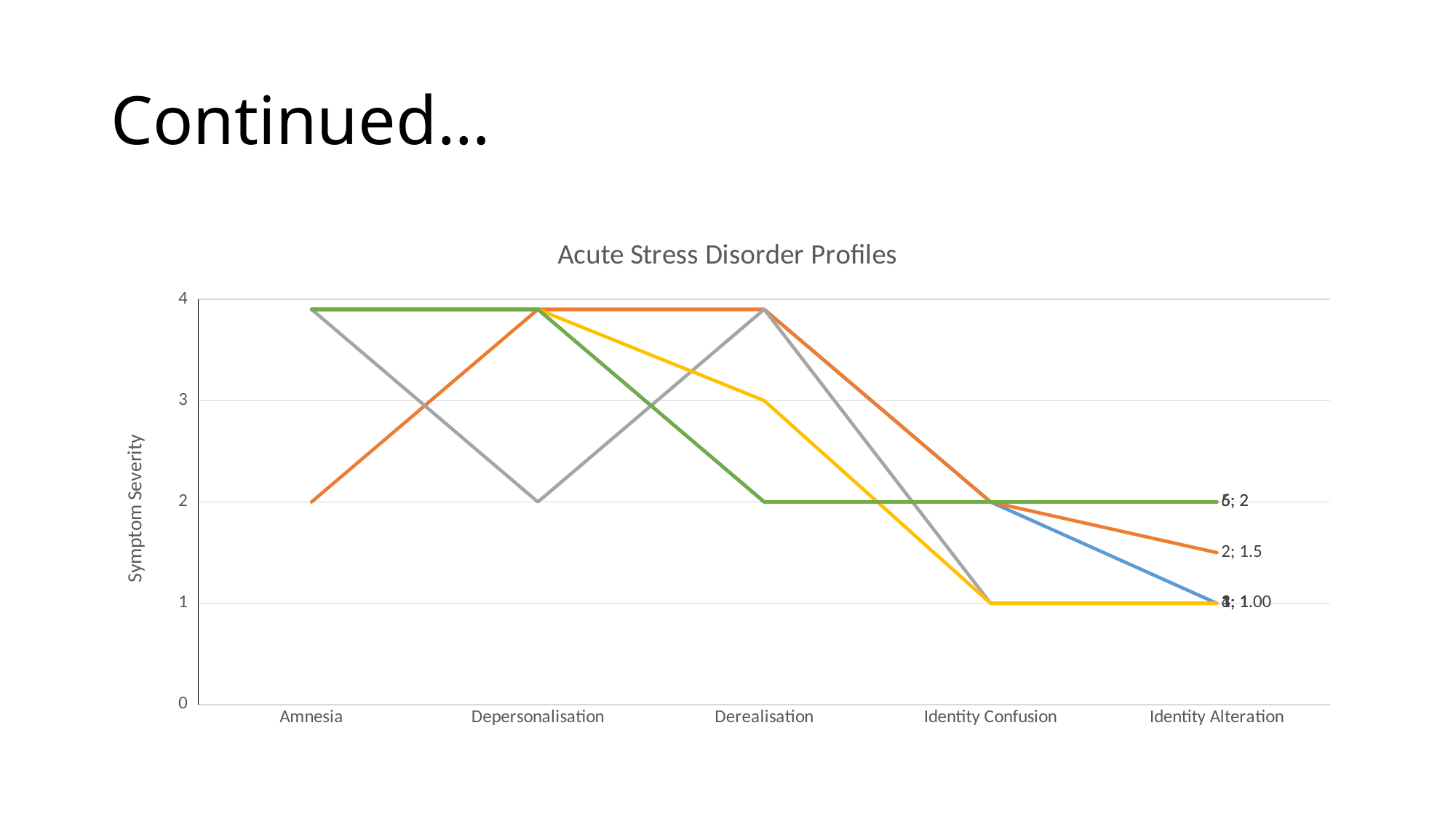
What is the value of the orange line at Amnesia? 2 What is the value of the orange line at Identity Alteration? 1.5 What is the value of the yellow line at Identity Confusion? 1 What is the title of the chart? Acute Stress Disorder Profiles Is the value of the green line at Amnesia greater or less than 3? greater At Amnesia, which line has the higher value, the orange line or the green line? green How many categories are shown along the x axis of the chart? 5 Does the orange line rise or fall from Derealisation to Identity Alteration? fall What is the value of the yellow line at Derealisation? 3 What kind of chart is shown on the slide? line chart What is the label on the vertical axis of the chart? Symptom Severity What is the value of the green line at Identity Alteration? 2